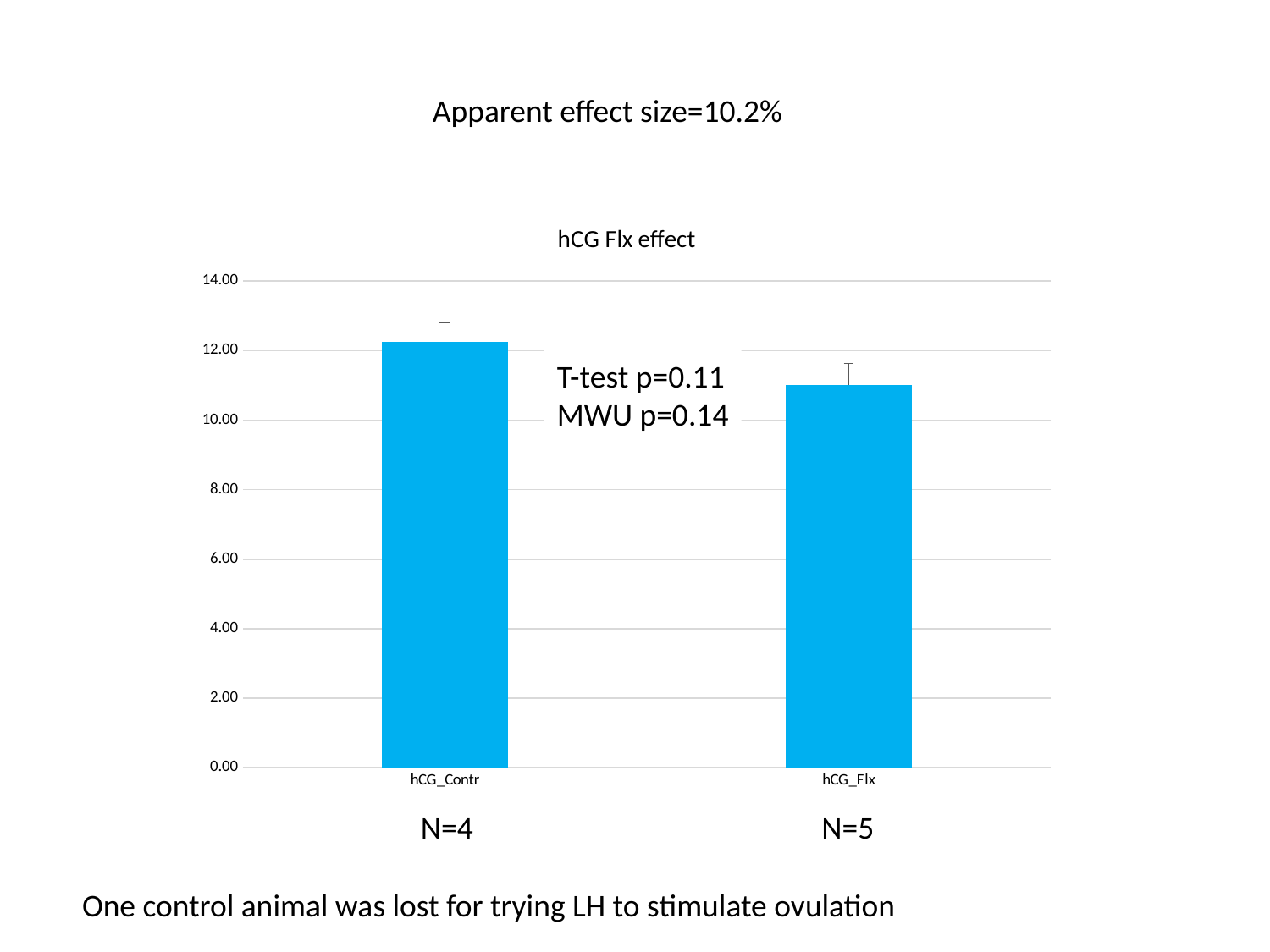
Is the value for hCG_Contr greater or less than 12.00? greater What is the title of the chart? hCG Flx effect Which category has the highest bar? hCG_Contr Do the bar values rise or fall from hCG_Contr to hCG_Flx? fall Which is larger, the value for hCG_Contr or the value for hCG_Flx? hCG_Contr Is the value for hCG_Flx greater or less than 10.00? greater What kind of chart is shown on the slide? bar chart What is the maximum value shown on the y axis? 14.00 How many categories are plotted in the chart? 2 Which category has the lowest bar? hCG_Flx Is the value for hCG_Flx greater or less than 12.00? less